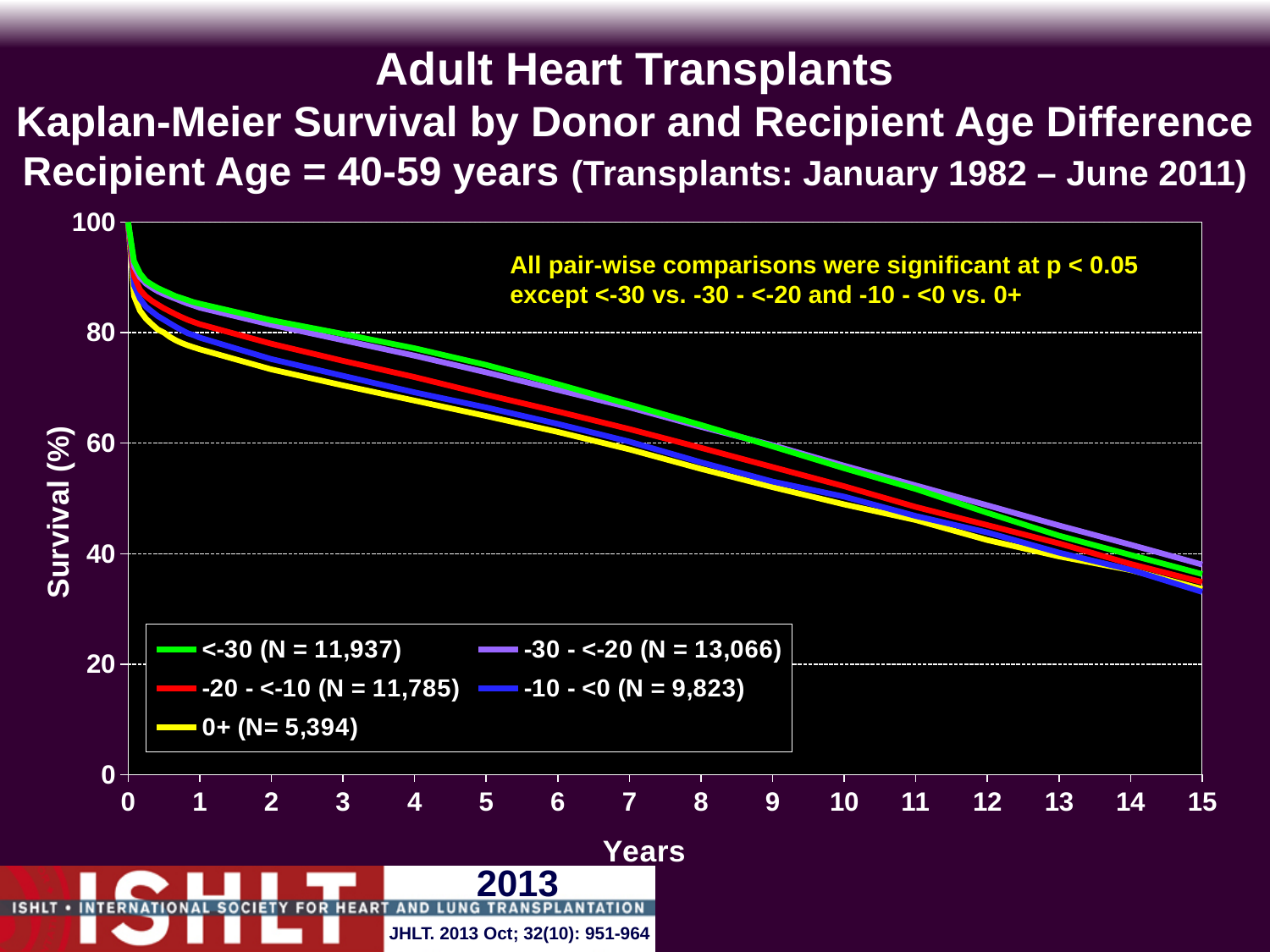
What is the N for the 0+ group shown in the legend? 5,394 What is the N for the -10 - <0 group shown in the legend? 9,823 Which group has the smallest N according to the legend? 0+ (N= 5,394) Which group has the largest N according to the legend? -30 - <-20 (N = 13,066) Is the survival value for the 0+ group at 2 years greater or less than 80? less Do the survival curves rise or fall as years increase? fall Is the survival value for the <-30 group at 5 years greater or less than 60? greater How many series does the legend list? 5 What is the difference between the N for the -30 - <-20 group and the N for the <-30 group? 1,129 What kind of chart is shown on the slide? line chart What is the N for the <-30 group shown in the legend? 11,937 What is the label of the y axis? Survival (%)